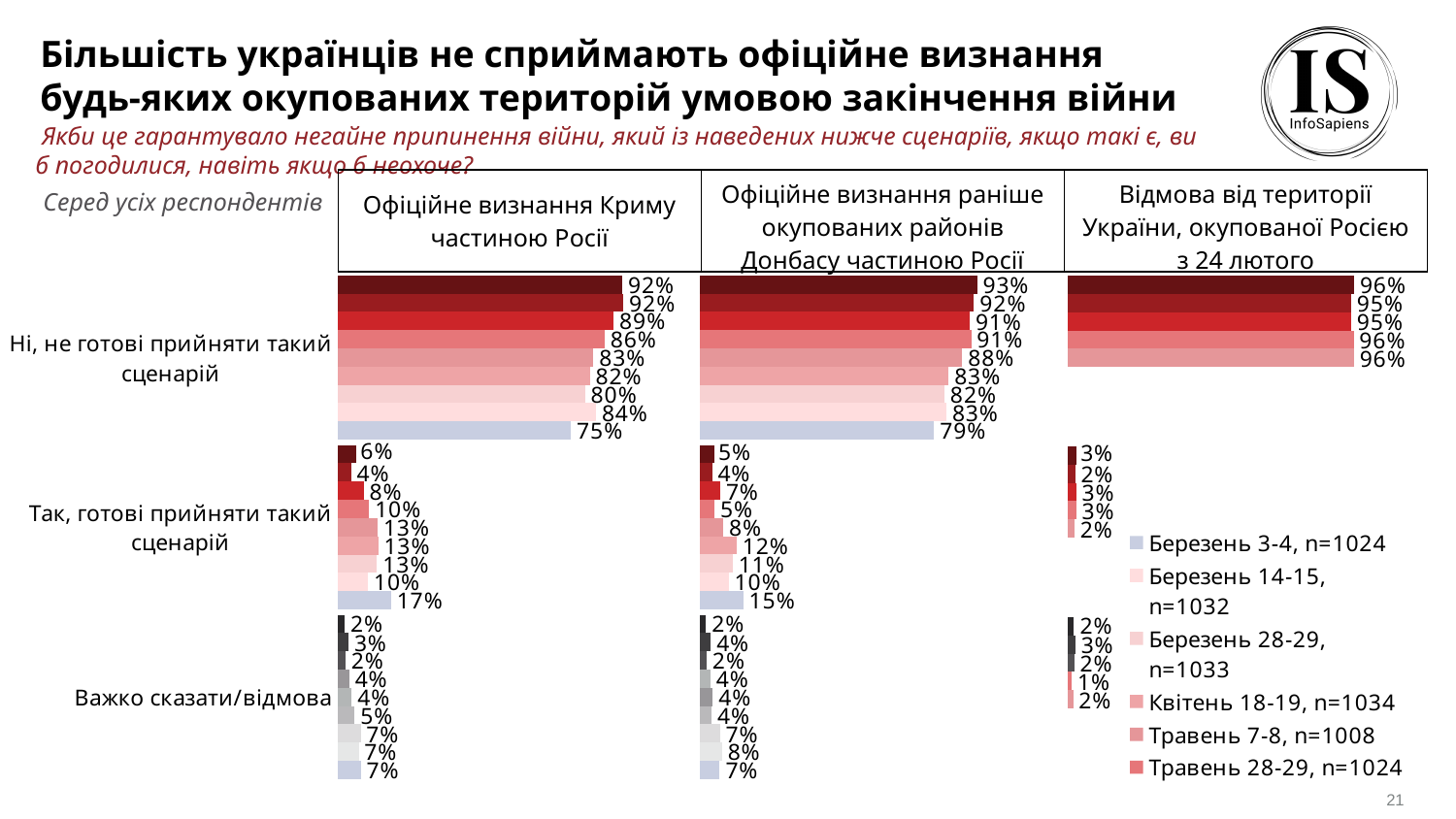
In the chart 'Офіційне визнання Криму частиною Росії', what is the value for 'Так, готові прийняти такий сценарій' in the Березень 3-4 wave (the bottom, light blue bar)? 17% How many response categories are shown on the vertical axis of each chart? 3 In the chart 'Офіційне визнання Криму частиною Росії', what is the value for 'Важко сказати/відмова' in the Березень 3-4 wave (the bottom, light blue bar)? 7% For the Березень 3-4 wave (bottom, light blue bar), which chart shows a larger 'Ні, не готові прийняти такий сценарій' value: 'Офіційне визнання Криму частиною Росії' or 'Офіційне визнання раніше окупованих районів Донбасу частиною Росії'? Офіційне визнання раніше окупованих районів Донбасу частиною Росії In the chart 'Відмова від території України, окупованої Росією з 24 лютого', what is the highest value shown for 'Ні, не готові прийняти такий сценарій'? 96% What type of chart is used on this slide? Bar chart In the chart 'Офіційне визнання Криму частиною Росії', what is the highest value shown for 'Ні, не готові прийняти такий сценарій'? 92% In the chart 'Офіційне визнання раніше окупованих районів Донбасу частиною Росії', what is the difference between the highest (93%) and lowest (79%) values for 'Ні, не готові прийняти такий сценарій'? 14 percentage points How many bars are shown for 'Ні, не готові прийняти такий сценарій' in the chart 'Відмова від території України, окупованої Росією з 24 лютого'? 5 In the chart 'Офіційне визнання раніше окупованих районів Донбасу частиною Росії', what is the value for 'Ні, не готові прийняти такий сценарій' in the Березень 3-4 wave (the bottom, light blue bar)? 79% In the chart 'Офіційне визнання Криму частиною Росії', what is the value for 'Ні, не готові прийняти такий сценарій' in the Березень 3-4 wave (the bottom, light blue bar)? 75% In the chart 'Офіційне визнання Криму частиною Росії', what is the lowest value shown for 'Ні, не готові прийняти такий сценарій'? 75%